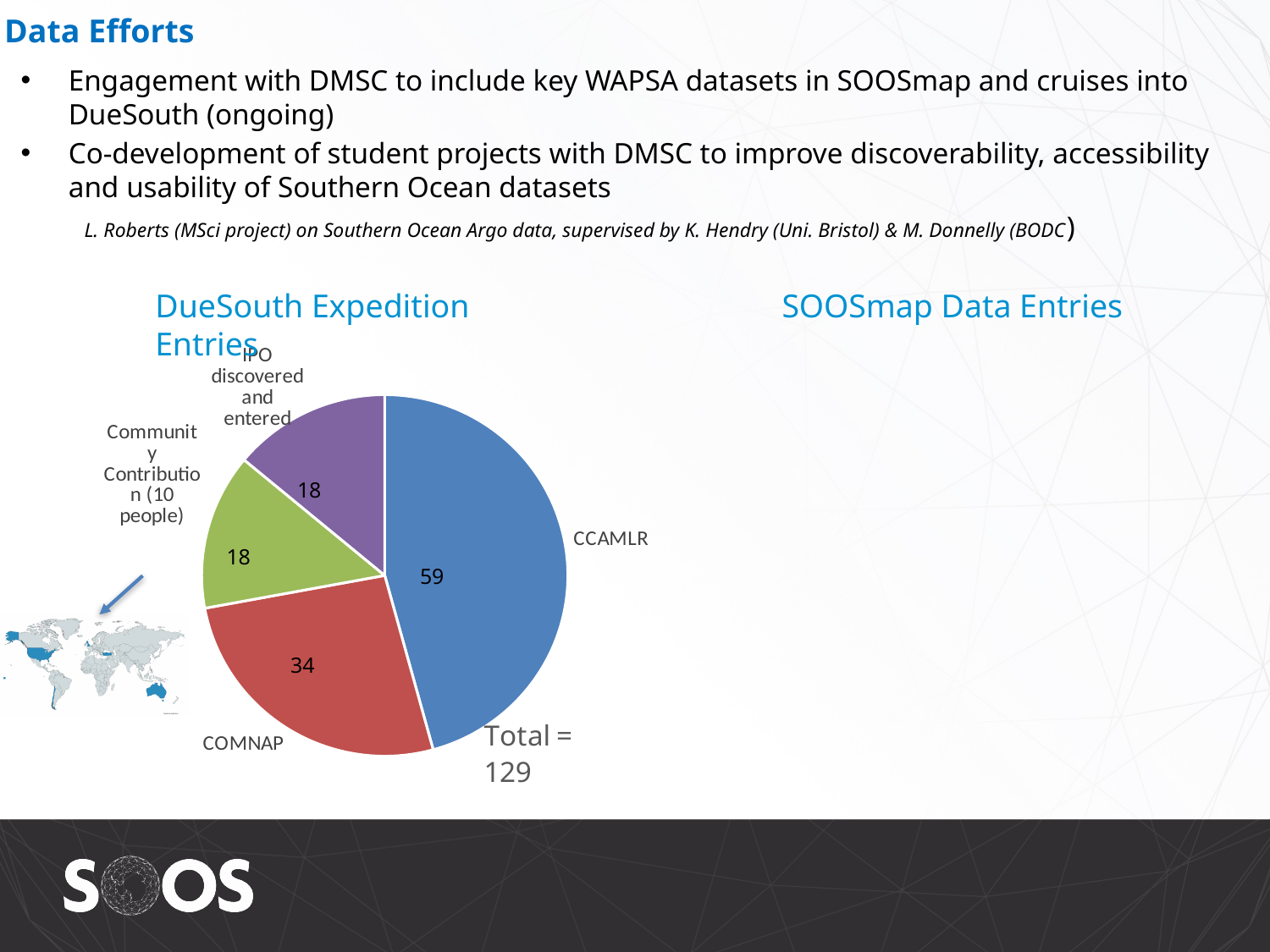
In the DueSouth Expedition Entries pie chart, what share of the total does CCAMLR represent, to the nearest whole percent? 46% In the DueSouth Expedition Entries pie chart, what is the value for IPO discovered and entered? 18 In the DueSouth Expedition Entries pie chart, what is the difference between the CCAMLR and COMNAP values? 25 In the DueSouth Expedition Entries pie chart, which is larger, CCAMLR or COMNAP? CCAMLR What type of chart is the DueSouth Expedition Entries chart? pie chart How many slices does the DueSouth Expedition Entries pie chart have? 4 What colour is the CCAMLR slice in the DueSouth Expedition Entries pie chart? blue In the DueSouth Expedition Entries pie chart, what is the value for Community Contribution (10 people)? 18 In the DueSouth Expedition Entries pie chart, what is the value for COMNAP? 34 What total is printed next to the DueSouth Expedition Entries pie chart? Total = 129 In the DueSouth Expedition Entries pie chart, what is the value for CCAMLR? 59 Which category has the largest slice in the DueSouth Expedition Entries pie chart? CCAMLR